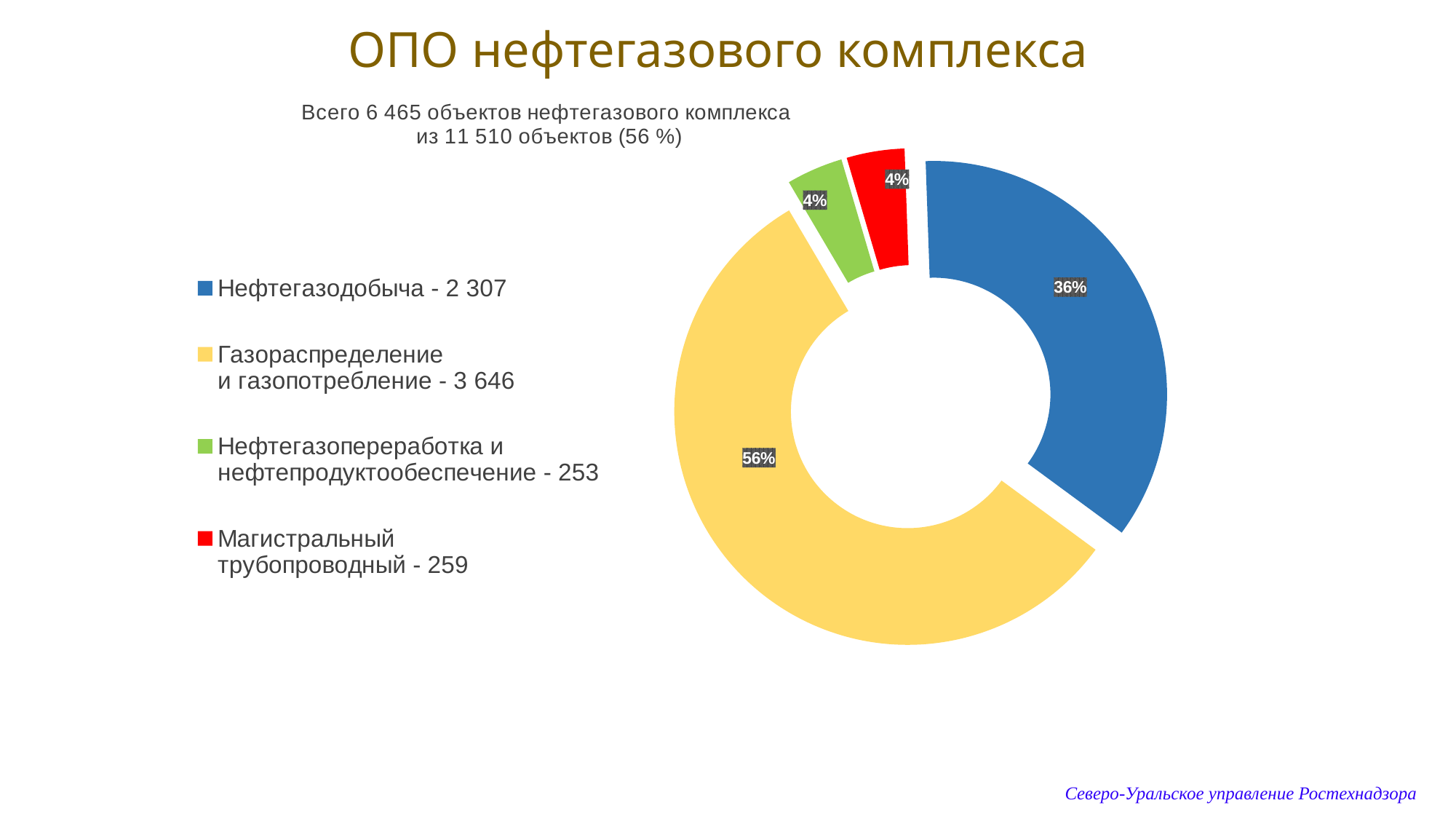
Which category has the smallest number of objects according to the legend? Нефтегазопереработка и нефтепродуктообеспечение According to the legend, how many objects are in the Нефтегазопереработка и нефтепродуктообеспечение category? 253 How many categories are shown in the pie chart? 4 What is the difference in the number of objects between Газораспределение и газопотребление (3 646) and Нефтегазодобыча (2 307)? 1 339 Which has more objects: Магистральный трубопроводный or Нефтегазопереработка и нефтепродуктообеспечение? Магистральный трубопроводный What share of the pie does Газораспределение и газопотребление hold? 56% What percentage is shown for the Нефтегазодобыча slice? 36% What colour is the Нефтегазодобыча slice? Blue Which category has the largest slice of the pie? Газораспределение и газопотребление What percentage is shown for the Магистральный трубопроводный slice? 4% According to the legend, how many objects are in the Нефтегазодобыча category? 2 307 What type of chart is shown on the slide? Pie chart (donut)